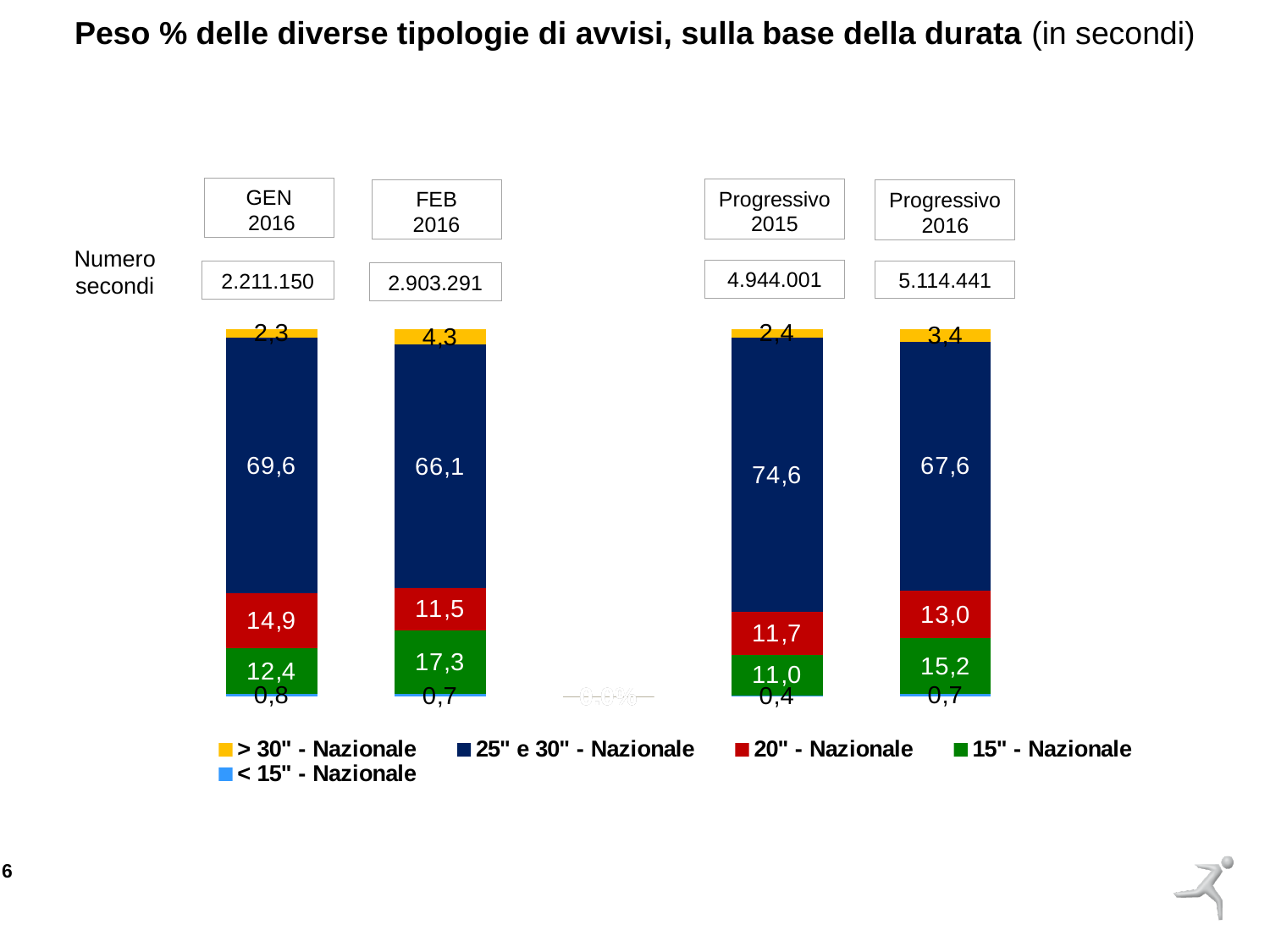
What is the value of the "> 30" - Nazionale" segment for FEB 2016? 4,3 Which has a larger "15" - Nazionale" value, FEB 2016 or Progressivo 2016? FEB 2016 What is the value of the "< 15" - Nazionale" segment for Progressivo 2015? 0,4 What is the value of the "25" e 30" - Nazionale" segment for GEN 2016? 69,6 Which bar has the highest value for the "25" e 30" - Nazionale" segment? Progressivo 2015 How many series does the legend list? 5 How many stacked bars are shown in the chart? 4 What is the value of the "20" - Nazionale" segment for Progressivo 2016? 13,0 Which bar has the lowest value for the "15" - Nazionale" segment? Progressivo 2015 What kind of chart is shown on the slide? Stacked bar chart What is the difference between the "20" - Nazionale" values for GEN 2016 and FEB 2016? 3,4 What is the value of the "15" - Nazionale" segment for FEB 2016? 17,3